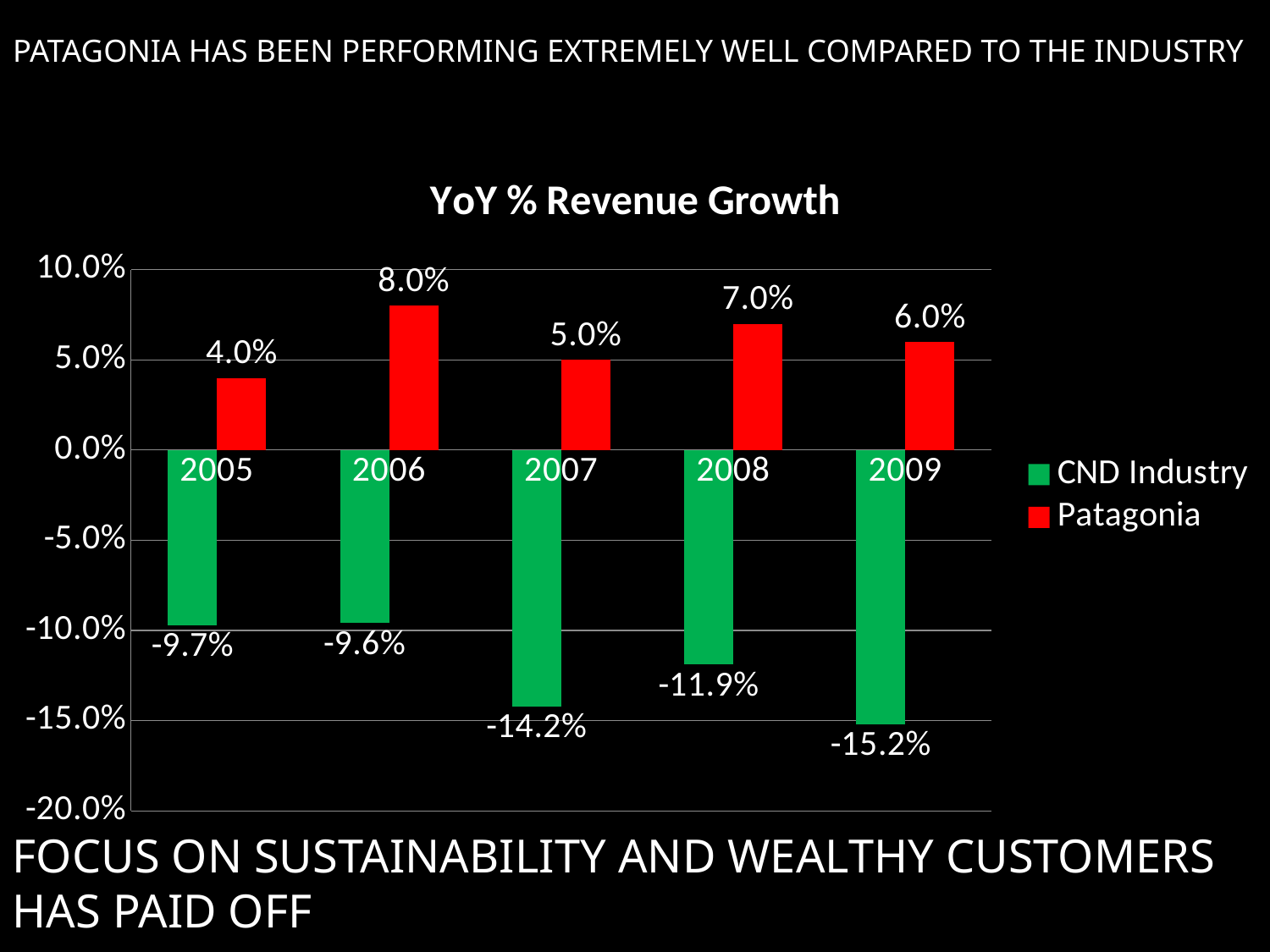
Which colour represents Patagonia in the chart? Red In which year was CND Industry's YoY % revenue growth lowest? 2009 What is the YoY % revenue growth for CND Industry in 2007? -14.2% How many series does the chart's legend list? 2 What is the difference between Patagonia's and CND Industry's YoY % revenue growth in 2008? 18.9% Which had higher YoY % revenue growth in 2005, Patagonia or CND Industry? Patagonia How many years are shown on the x axis of the chart? 5 What is the title of the chart? YoY % Revenue Growth What is the YoY % revenue growth for Patagonia in 2006? 8.0% What kind of chart is shown on the slide? Bar chart What is the YoY % revenue growth for CND Industry in 2009? -15.2% In which year was Patagonia's YoY % revenue growth highest? 2006